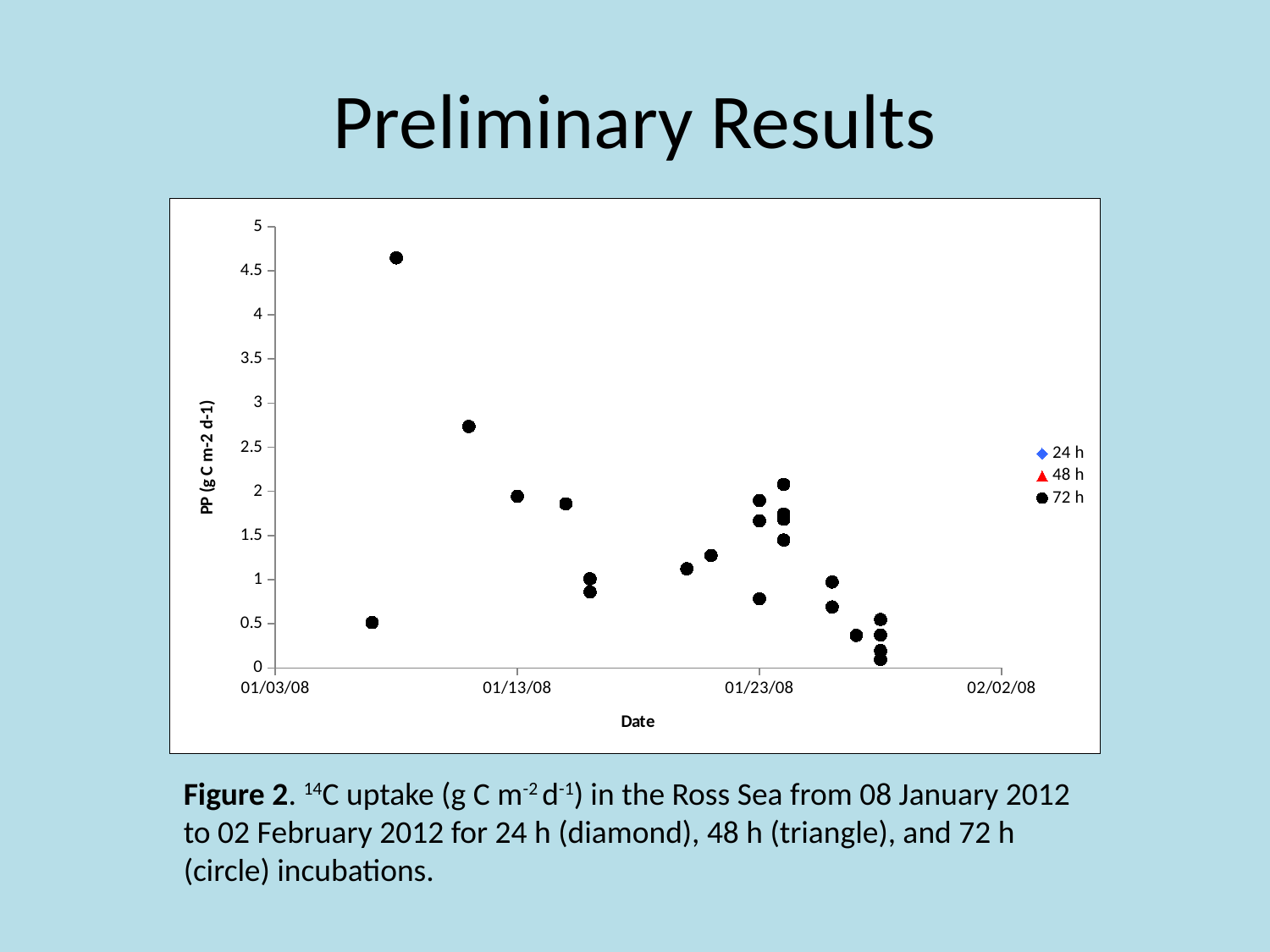
What are the three series named in the chart's legend? 24 h, 48 h, 72 h Is the lowest plotted value on the chart greater or less than 0.5? less Do the plotted values generally rise or fall from the earliest dates to the latest dates on the x axis? fall What is the label of the chart's y axis? PP (g C m-2 d-1) Is the highest plotted value on the chart greater or less than 4? greater How many series does the chart's legend list? 3 What kind of chart is shown on the slide? Scatter chart Is the highest point plotted between 01/03/08 and 01/13/08 greater or less than 3? greater Which series' marker symbol is a circle according to the legend? 72 h